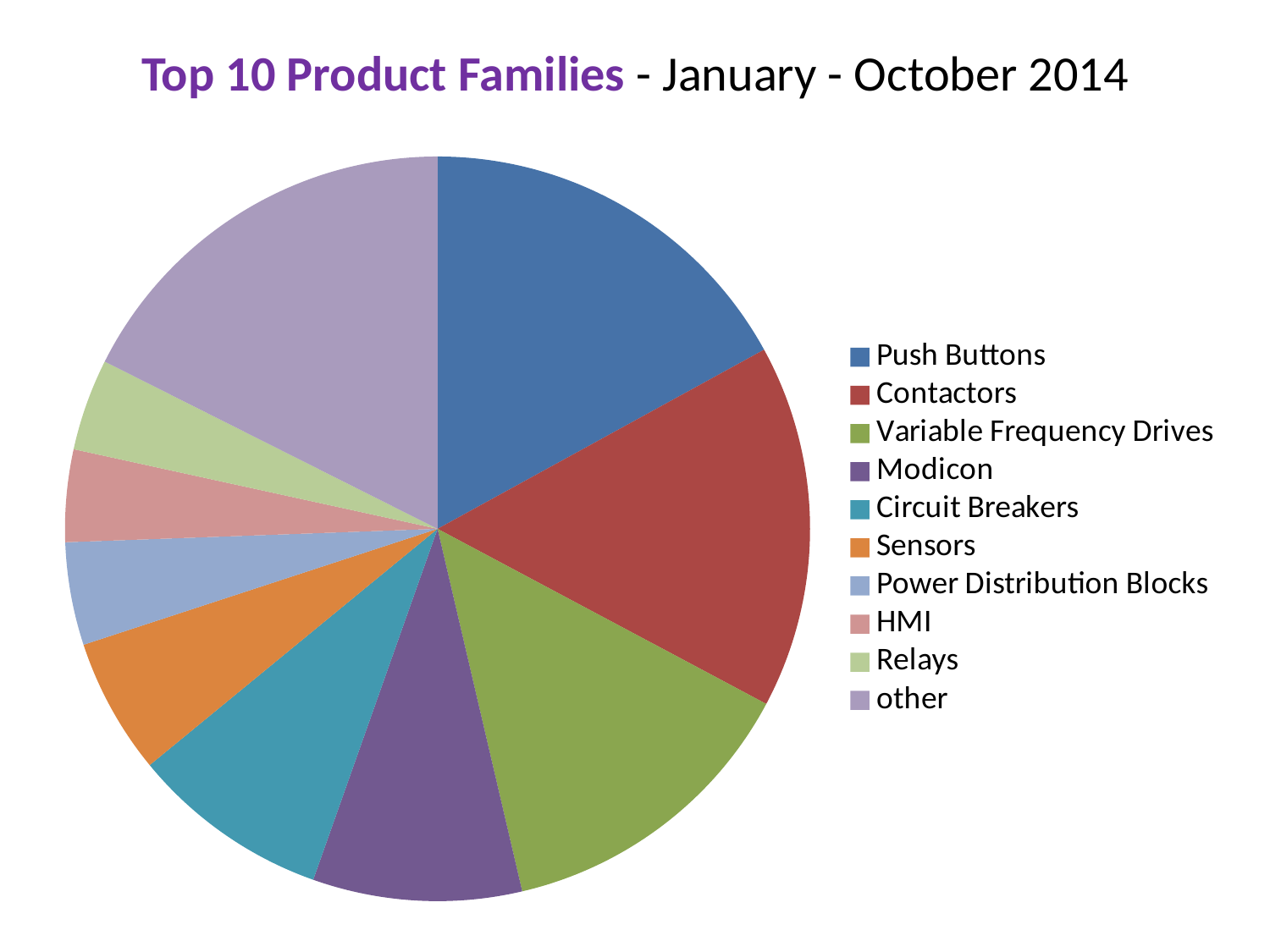
What is the title of the chart? Top 10 Product Families - January - October 2014 Which slice is larger, other or Circuit Breakers? other Which slice is larger, Contactors or Sensors? Contactors What colour is the Push Buttons slice? blue Which slice is larger, Push Buttons or HMI? Push Buttons What kind of chart is shown on the slide? pie chart How many entries does the legend list? 10 How many slices does the pie chart have? 10